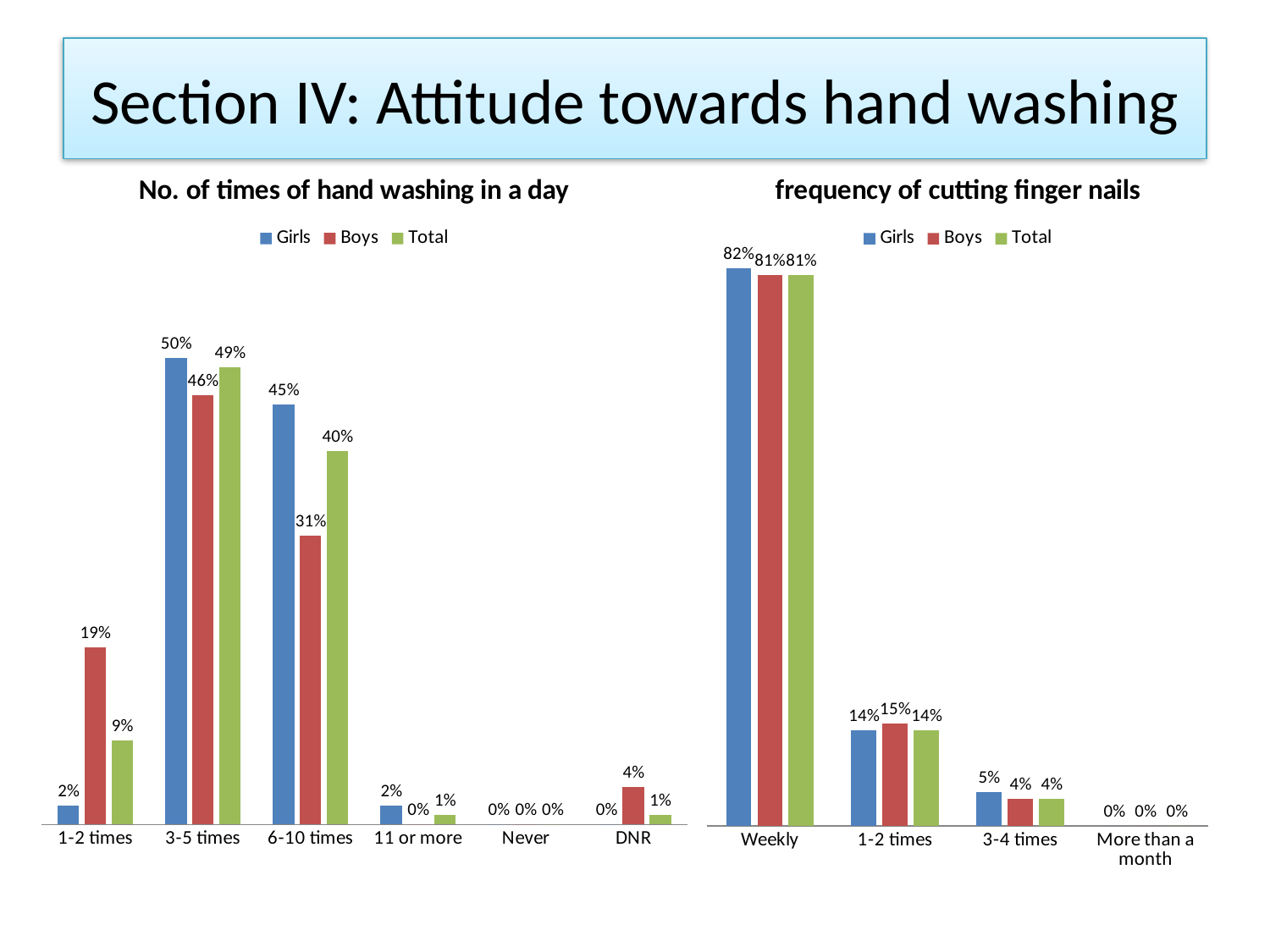
In the 'frequency of cutting finger nails' chart, what is the difference between the Weekly and 1-2 times values for Total? 67% In the 'frequency of cutting finger nails' chart, what is the value for Girls in the Weekly category? 82% In the 'frequency of cutting finger nails' chart, what is the value for Boys in the 1-2 times category? 15% In the 'No. of times of hand washing in a day' chart, which is larger in the 3-5 times category, Girls or Boys? Girls In the 'No. of times of hand washing in a day' chart, what is the value for Girls in the 6-10 times category? 45% In the 'No. of times of hand washing in a day' chart, what is the value for Boys in the 1-2 times category? 19% In the 'No. of times of hand washing in a day' chart, what is the difference between the Girls and Boys values in the 6-10 times category? 14% How many categories are shown on the x axis of the 'No. of times of hand washing in a day' chart? 6 How many series does the legend of the 'frequency of cutting finger nails' chart list? 3 In the 'No. of times of hand washing in a day' chart, which category has the highest value for Girls? 3-5 times What kind of chart is the 'frequency of cutting finger nails' chart? Bar chart In the 'frequency of cutting finger nails' chart, which category has the lowest value for Total? More than a month